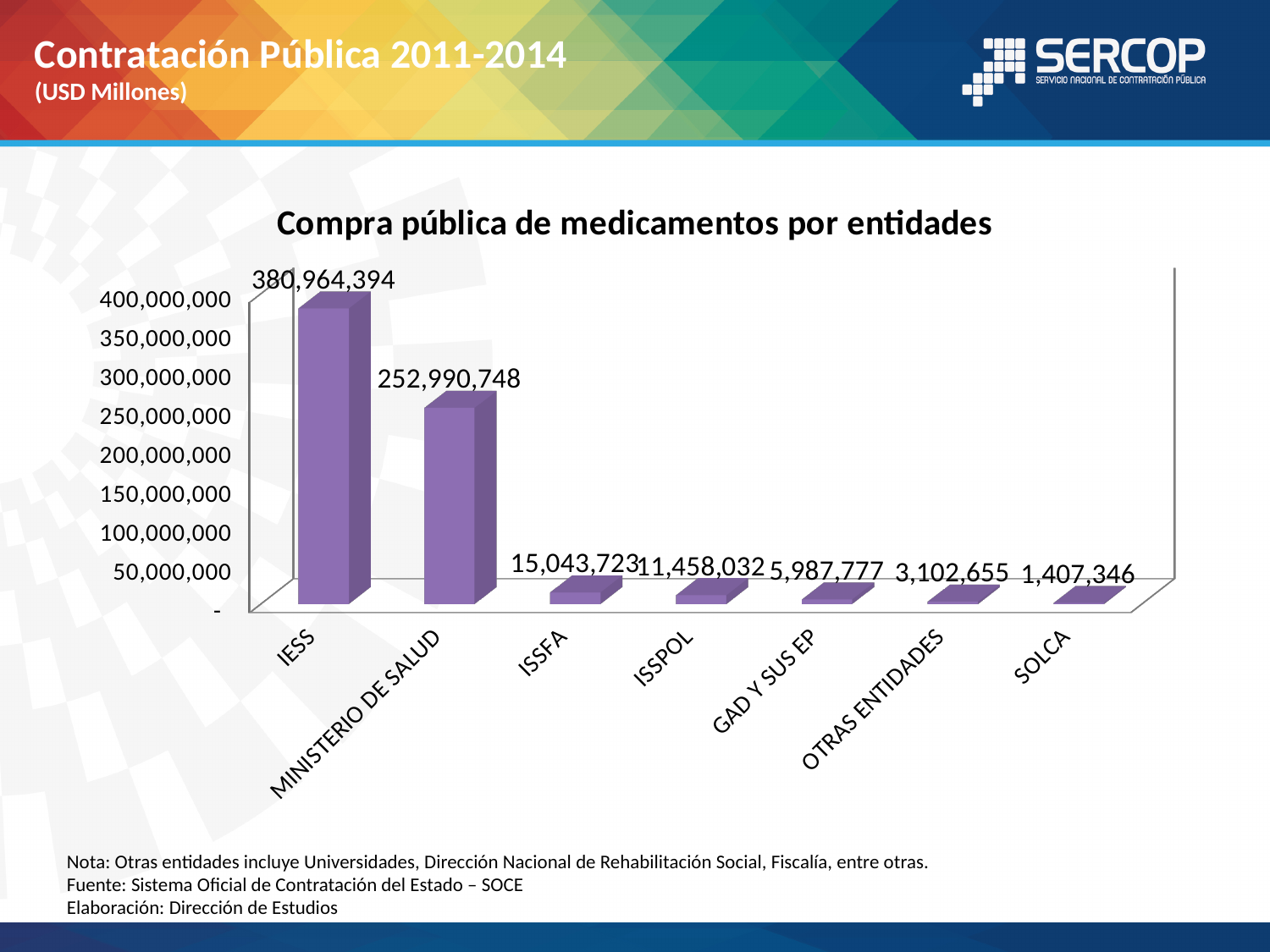
Is the value for MINISTERIO DE SALUD greater or less than 300,000,000? less Which entity has the highest value in the chart? IESS Which is larger, the value for ISSFA or the value for ISSPOL? ISSFA What is the value for IESS in the chart? 380,964,394 What is the value for SOLCA? 1,407,346 What is the title of the chart? Compra pública de medicamentos por entidades What is the value for ISSFA? 15,043,723 Which entity has the lowest value in the chart? SOLCA How many entities are shown in the chart? 7 What kind of chart is shown on the slide? bar chart What is the value for MINISTERIO DE SALUD? 252,990,748 What is the difference between the values for IESS and MINISTERIO DE SALUD? 127,973,646